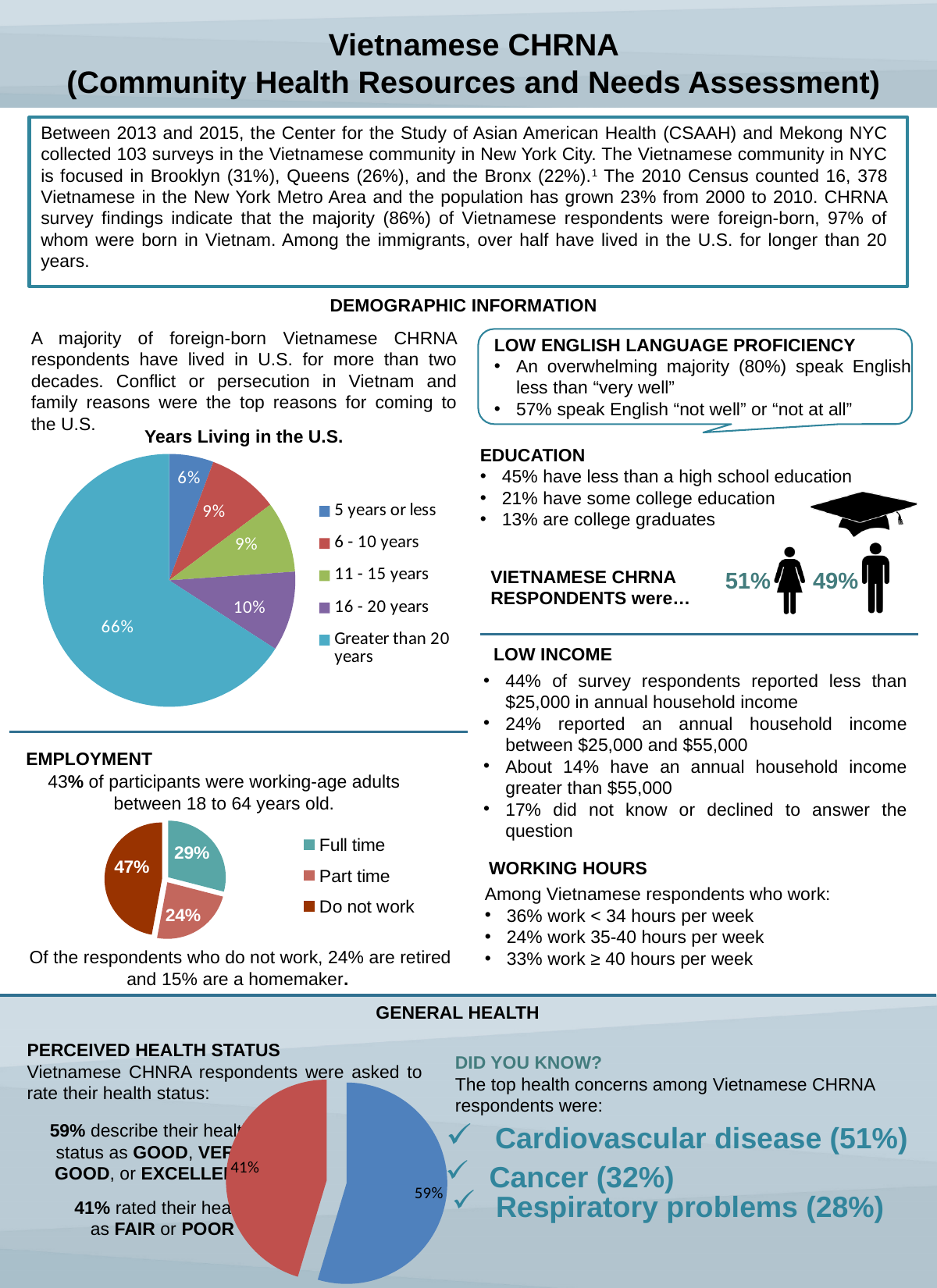
In the Employment pie chart, how many categories are shown? 3 What kind of chart is the 'Years Living in the U.S.' chart? Pie chart In the Employment pie chart, what share of participants work part time? 24% In the 'Years Living in the U.S.' chart, what share of respondents have lived in the U.S. for greater than 20 years? 66% In the Employment pie chart, what share of participants do not work? 47% In the 'Years Living in the U.S.' chart, how many categories does the legend list? 5 In the 'Years Living in the U.S.' chart, what share of respondents have lived in the U.S. for 5 years or less? 6% In the 'Years Living in the U.S.' chart, which category has the largest share? Greater than 20 years In the 'Years Living in the U.S.' chart, what is the difference between the share for 16 - 20 years and the share for 5 years or less? 4% In the Employment pie chart, which is larger: Full time or Part time? Full time In the Perceived Health Status pie chart at the bottom of the slide, what share is shown for the blue slice? 59% In the 'Years Living in the U.S.' chart, which category has the smallest share? 5 years or less